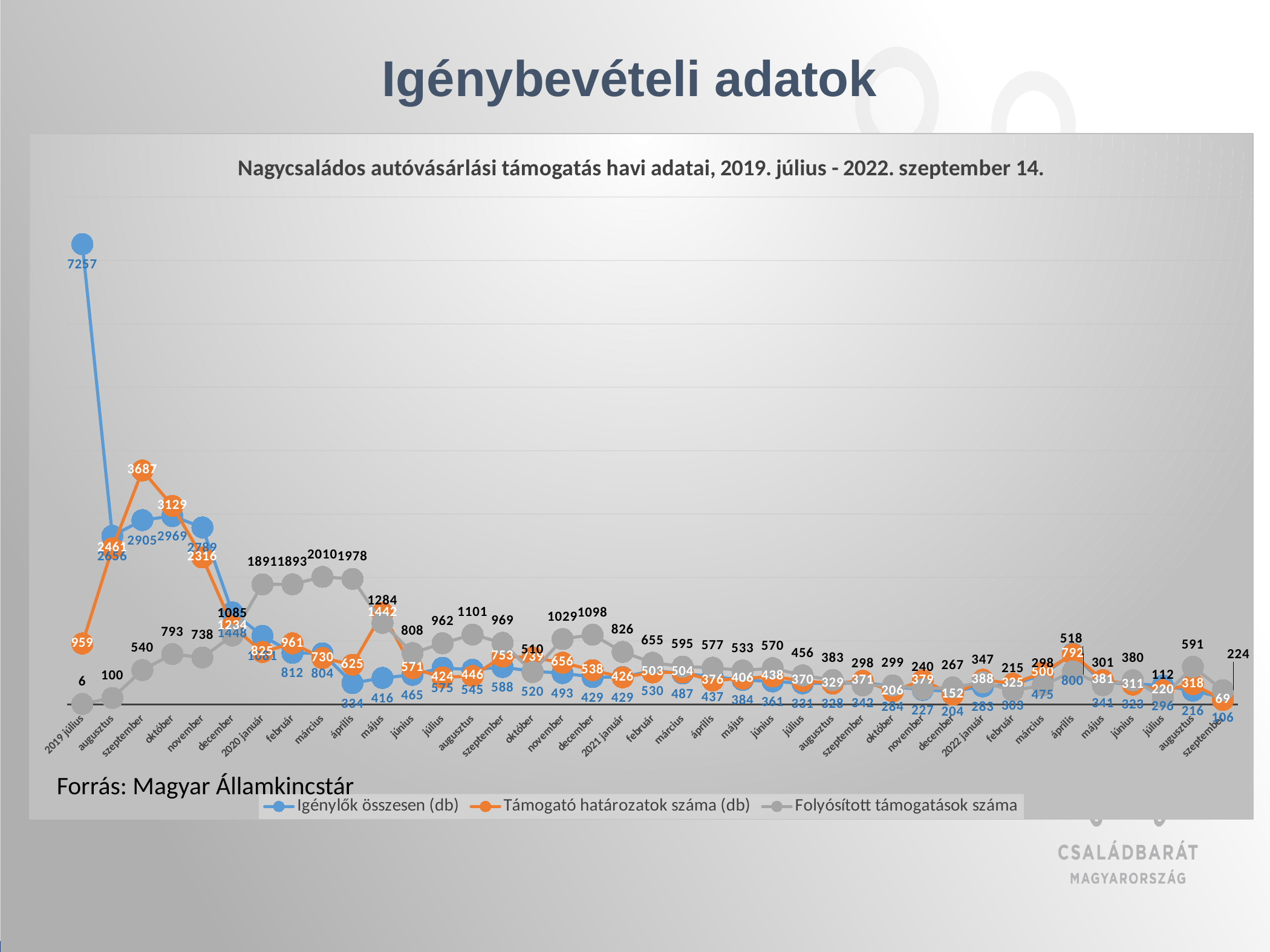
What kind of chart is shown on the slide? line chart What is the value of Támogató határozatok száma (db) for 2019 szeptember? 3687 What is the title of the chart? Nagycsaládos autóvásárlási támogatás havi adatai, 2019. július - 2022. szeptember 14. Which is larger in 2022 április: Igénylők összesen (db) or Támogató határozatok száma (db)? Igénylők összesen (db) In which month is Folyósított támogatások száma lowest? 2019 július What is the value of Igénylők összesen (db) for 2019 július? 7257 How many series does the legend list? 3 Does Igénylők összesen (db) generally rise or fall from 2019 július to 2022 szeptember? fall What is the value of Folyósított támogatások száma for 2020 március? 2010 What is the value of Igénylők összesen (db) for 2022 szeptember? 106 What is the difference between Folyósított támogatások száma in 2022 augusztus (591) and 2022 szeptember (224)? 367 In which month does Támogató határozatok száma (db) reach its highest value? 2019 szeptember